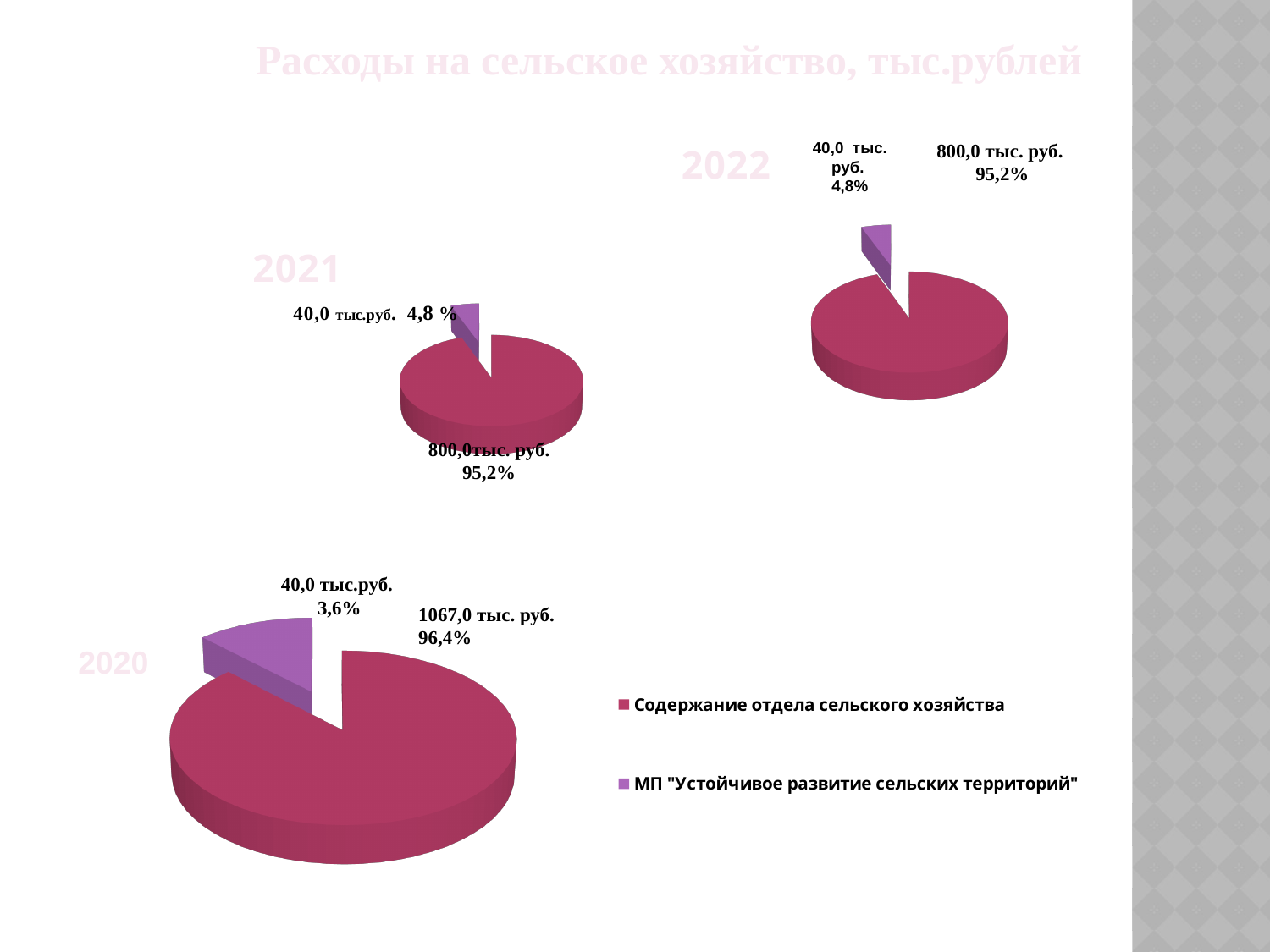
How many series does the legend list? 2 How many pie charts are on the slide? 3 In the 2020 pie chart, what is the value for Содержание отдела сельского хозяйства? 1067,0 тыс. руб. In the 2022 pie chart, what is the value for МП "Устойчивое развитие сельских территорий"? 40,0 тыс. руб. In the 2021 pie chart, what share does Содержание отдела сельского хозяйства have? 95,2% In the 2020 pie chart, what share does МП "Устойчивое развитие сельских территорий" have? 3,6% In the 2020 pie chart, which category is the largest? Содержание отдела сельского хозяйства What is the title of the slide's charts? Расходы на сельское хозяйство, тыс.рублей In the 2020 pie chart, what is the difference between the values for Содержание отдела сельского хозяйства and МП "Устойчивое развитие сельских территорий"? 1027,0 тыс. руб. What type of charts are shown on the slide? Pie charts In the 2022 pie chart, what share does МП "Устойчивое развитие сельских территорий" have? 4,8% In the 2021 pie chart, what is the value for Содержание отдела сельского хозяйства? 800,0 тыс. руб.